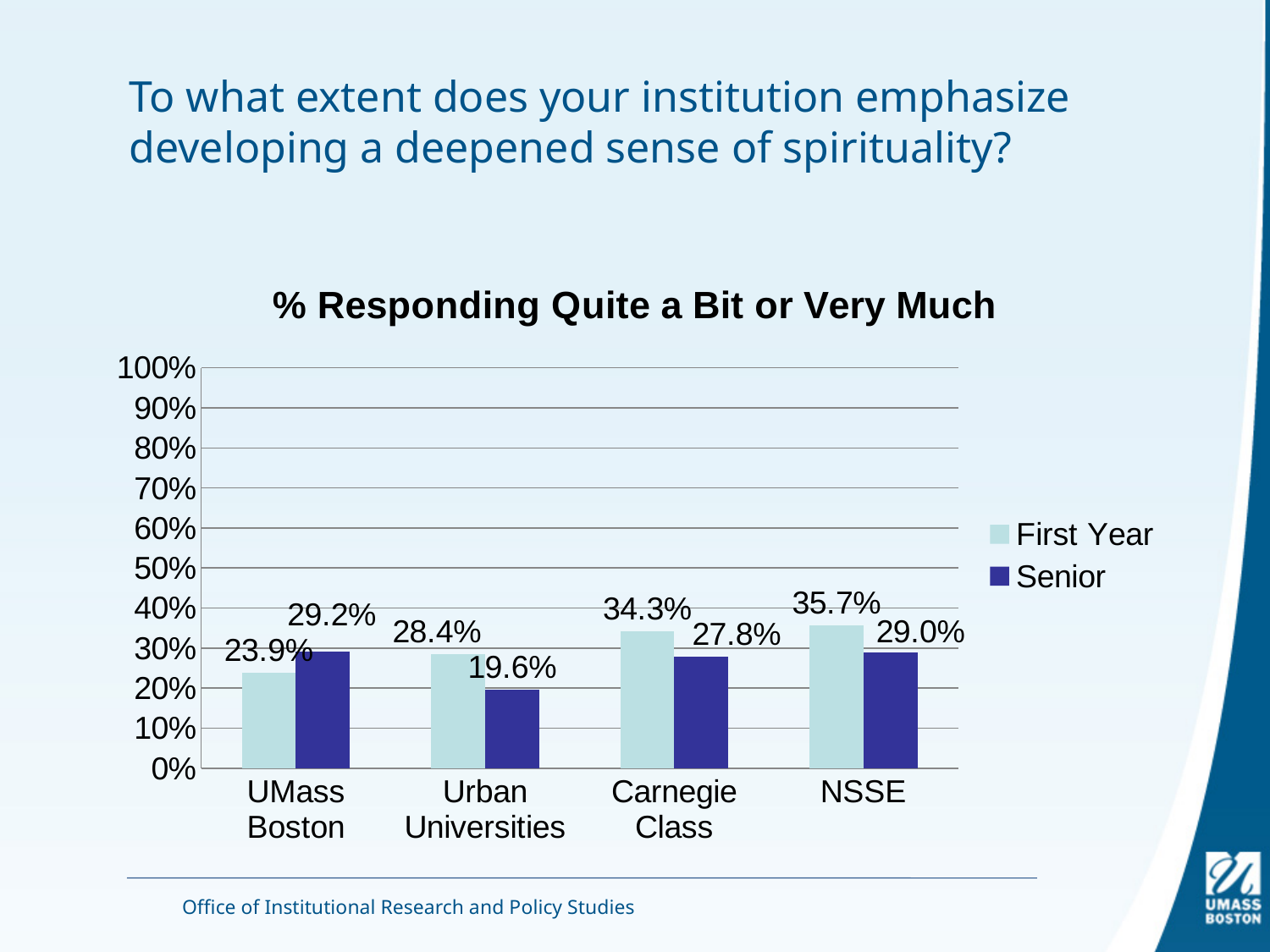
What is the difference between the First Year and Senior values for Carnegie Class? 6.5% How many categories are shown on the x axis? 4 How many series does the legend list? 2 What is the difference between the Senior values for UMass Boston and NSSE? 0.2% Which category has the lowest Senior value? Urban Universities What is the title of the chart? % Responding Quite a Bit or Very Much What kind of chart is shown on the slide? Bar chart What is the First Year value for UMass Boston? 23.9% What is the First Year value for NSSE? 35.7% For UMass Boston, which is larger: the First Year value or the Senior value? Senior Which category has the highest First Year value? NSSE What is the Senior value for Urban Universities? 19.6%